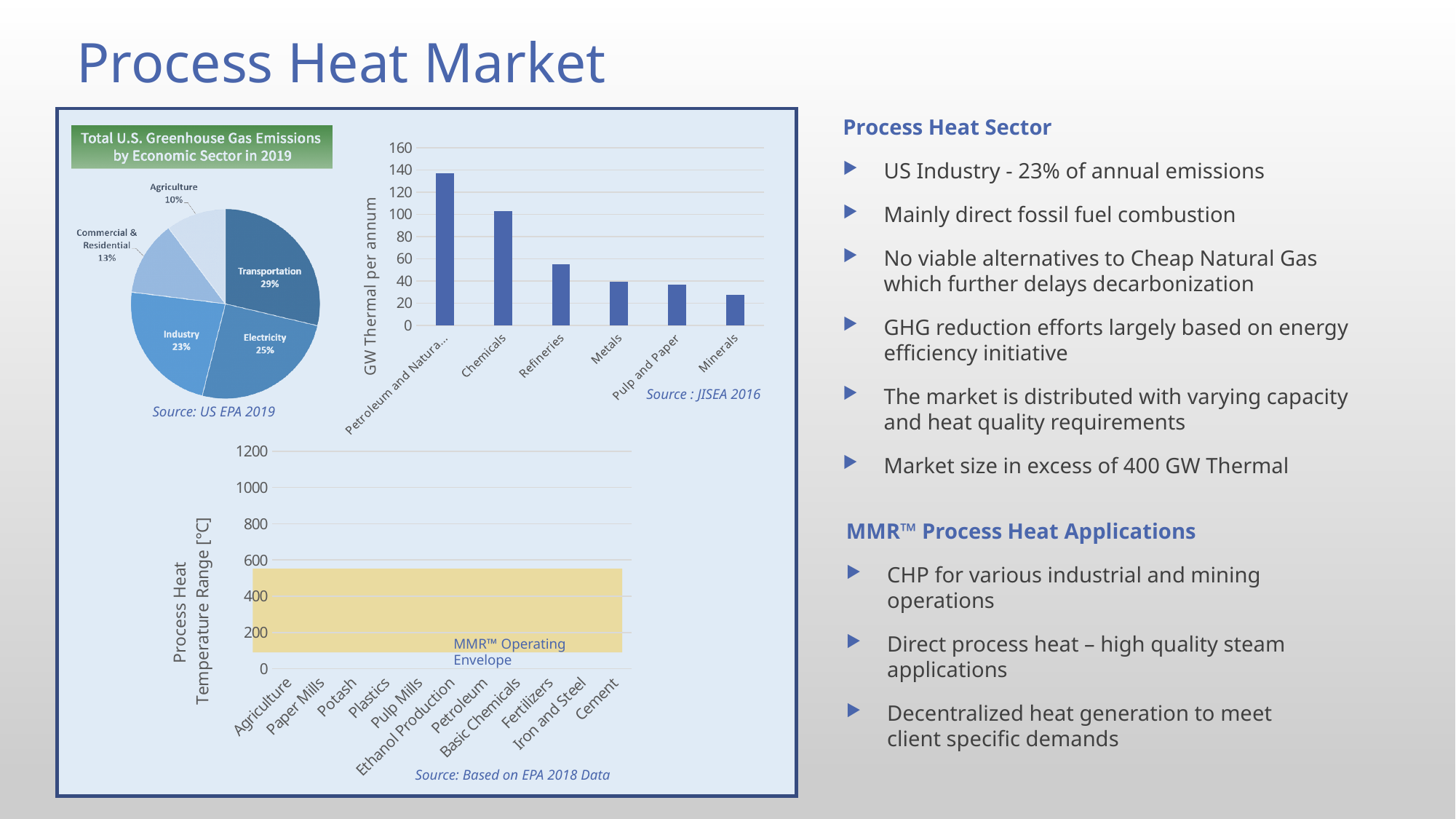
How many sectors are shown in the pie chart 'Total U.S. Greenhouse Gas Emissions by Economic Sector in 2019'? 5 In the pie chart 'Total U.S. Greenhouse Gas Emissions by Economic Sector in 2019', what is the difference in percentage points between Electricity and Commercial & Residential? 12 In the bar chart of GW Thermal per annum (top right), is the value for Refineries greater or less than 60? less In the bar chart of GW Thermal per annum (top right), do the values rise or fall from left to right along the x axis? fall In the bar chart of GW Thermal per annum (top right), is the value for Chemicals greater or less than 80? greater In the pie chart 'Total U.S. Greenhouse Gas Emissions by Economic Sector in 2019', what share does Transportation have? 29% In the pie chart 'Total U.S. Greenhouse Gas Emissions by Economic Sector in 2019', which sector has the largest share? Transportation In the bar chart of GW Thermal per annum (top right), which category has the lowest value? Minerals In the pie chart 'Total U.S. Greenhouse Gas Emissions by Economic Sector in 2019', which sector has the smallest share? Agriculture What type of chart is the top-right chart showing GW Thermal per annum? bar chart In the pie chart 'Total U.S. Greenhouse Gas Emissions by Economic Sector in 2019', what share does Industry have? 23% In the bar chart of GW Thermal per annum (top right), which category has the highest value? Petroleum and Natural Gas